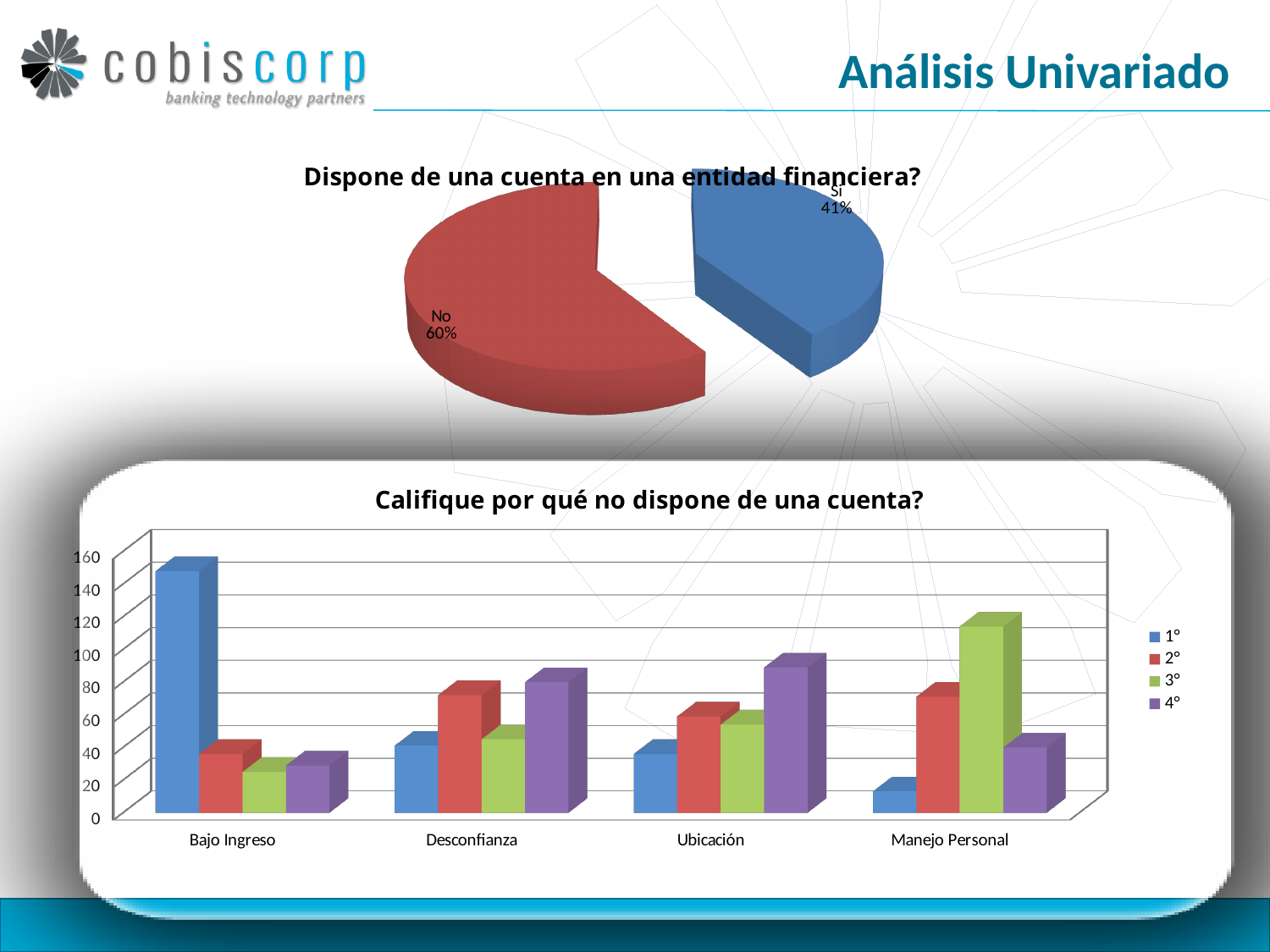
In the pie chart 'Dispone de una cuenta en una entidad financiera?', what percentage answered No? 60% In the bar chart 'Califique por qué no dispone de una cuenta?', is the 1° value for Bajo Ingreso greater or less than 120? greater In the bar chart 'Califique por qué no dispone de una cuenta?', is the 1° value for Manejo Personal greater or less than 40? less In the pie chart 'Dispone de una cuenta en una entidad financiera?', which answer has the larger share? No What kind of chart is the top chart 'Dispone de una cuenta en una entidad financiera?'? Pie chart How many categories are shown on the x axis of the bar chart 'Califique por qué no dispone de una cuenta?'? 4 In the bar chart 'Califique por qué no dispone de una cuenta?', which series has the highest bar for Bajo Ingreso? 1° In the bar chart 'Califique por qué no dispone de una cuenta?', which series has the highest bar for Manejo Personal? 3° In the bar chart 'Califique por qué no dispone de una cuenta?', for Ubicación, which is larger: the 1° bar or the 4° bar? 4° In the pie chart 'Dispone de una cuenta en una entidad financiera?', what percentage answered Si? 41% How many series does the legend of the bar chart 'Califique por qué no dispone de una cuenta?' list? 4 What kind of chart is the bottom chart 'Califique por qué no dispone de una cuenta?'? Bar chart